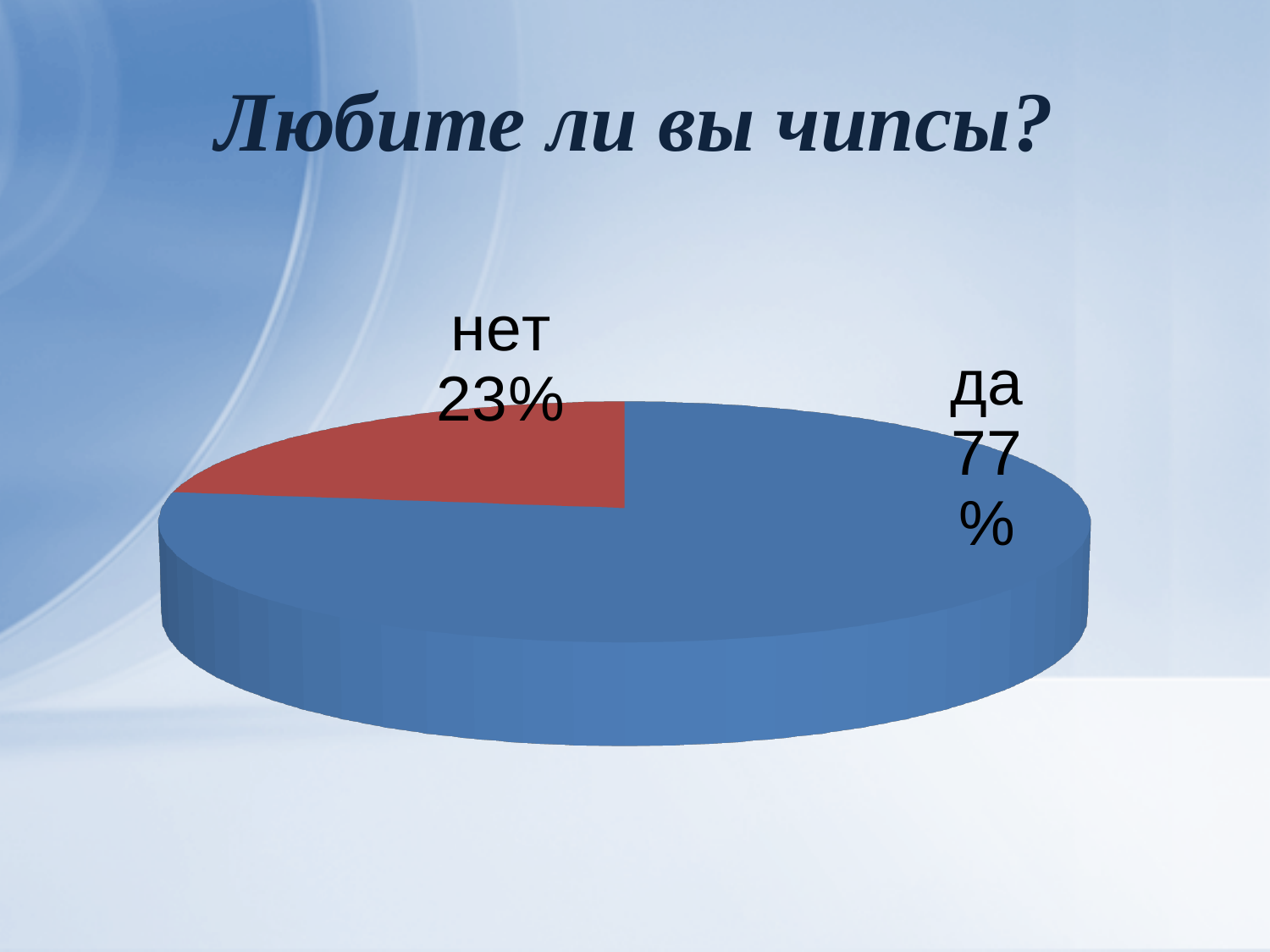
What kind of chart is shown on the slide? pie chart What share of the pie does "да" take? 77% Is the share for "да" greater or less than 50%? greater Which slice of the pie is the largest? да What share of the pie does "нет" take? 23% Which is larger, the share for "да" or the share for "нет"? да What is the total of the two slices' percentages? 100% What is the difference in percentage points between "да" and "нет"? 54 What is the title of the slide above the chart? Любите ли вы чипсы? What colour is the "нет" slice? red How many slices does the pie chart have? 2 Which slice of the pie is the smallest? нет